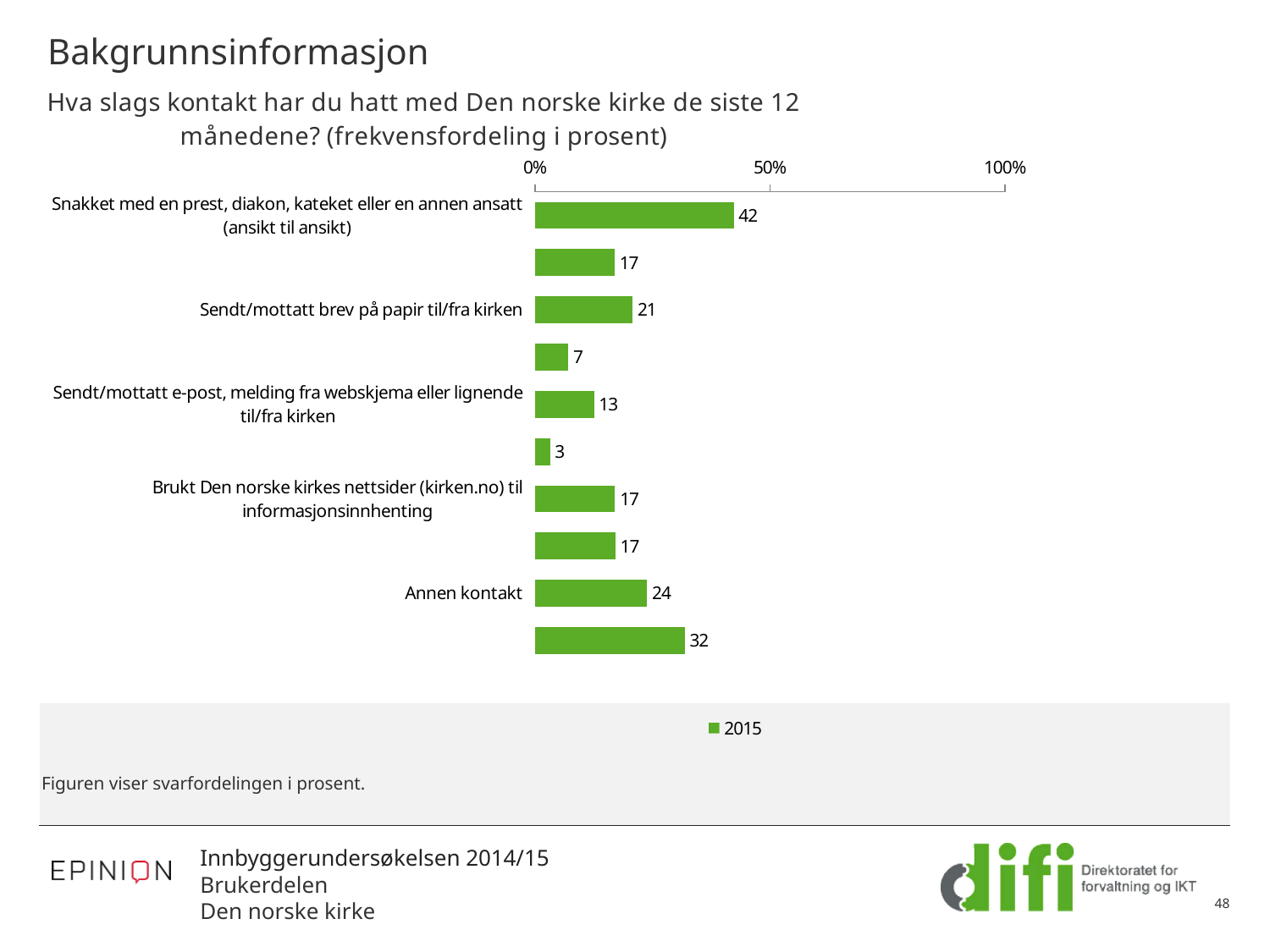
What is the value for "Sendt/mottatt e-post, melding fra webskjema eller lignende til/fra kirken"? 13 What is the value for "Sendt/mottatt brev på papir til/fra kirken"? 21 What is the value for "Brukt Den norske kirkes nettsider (kirken.no) til informasjonsinnhenting"? 17 What is the value for "Annen kontakt"? 24 Which is larger: the value for "Sendt/mottatt brev på papir til/fra kirken" or the value for "Sendt/mottatt e-post, melding fra webskjema eller lignende til/fra kirken"? Sendt/mottatt brev på papir til/fra kirken Which category has the highest value in the chart? Snakket med en prest, diakon, kateket eller en annen ansatt (ansikt til ansikt) How many series does the legend list? 1 Is the value for "Snakket med en prest, diakon, kateket eller en annen ansatt (ansikt til ansikt)" greater or less than 50%? less What kind of chart is shown on the slide? bar chart How many bars are plotted in the chart? 10 What is the value for "Snakket med en prest, diakon, kateket eller en annen ansatt (ansikt til ansikt)"? 42 What is the difference between the value for "Snakket med en prest, diakon, kateket eller en annen ansatt (ansikt til ansikt)" and the value for "Annen kontakt"? 18